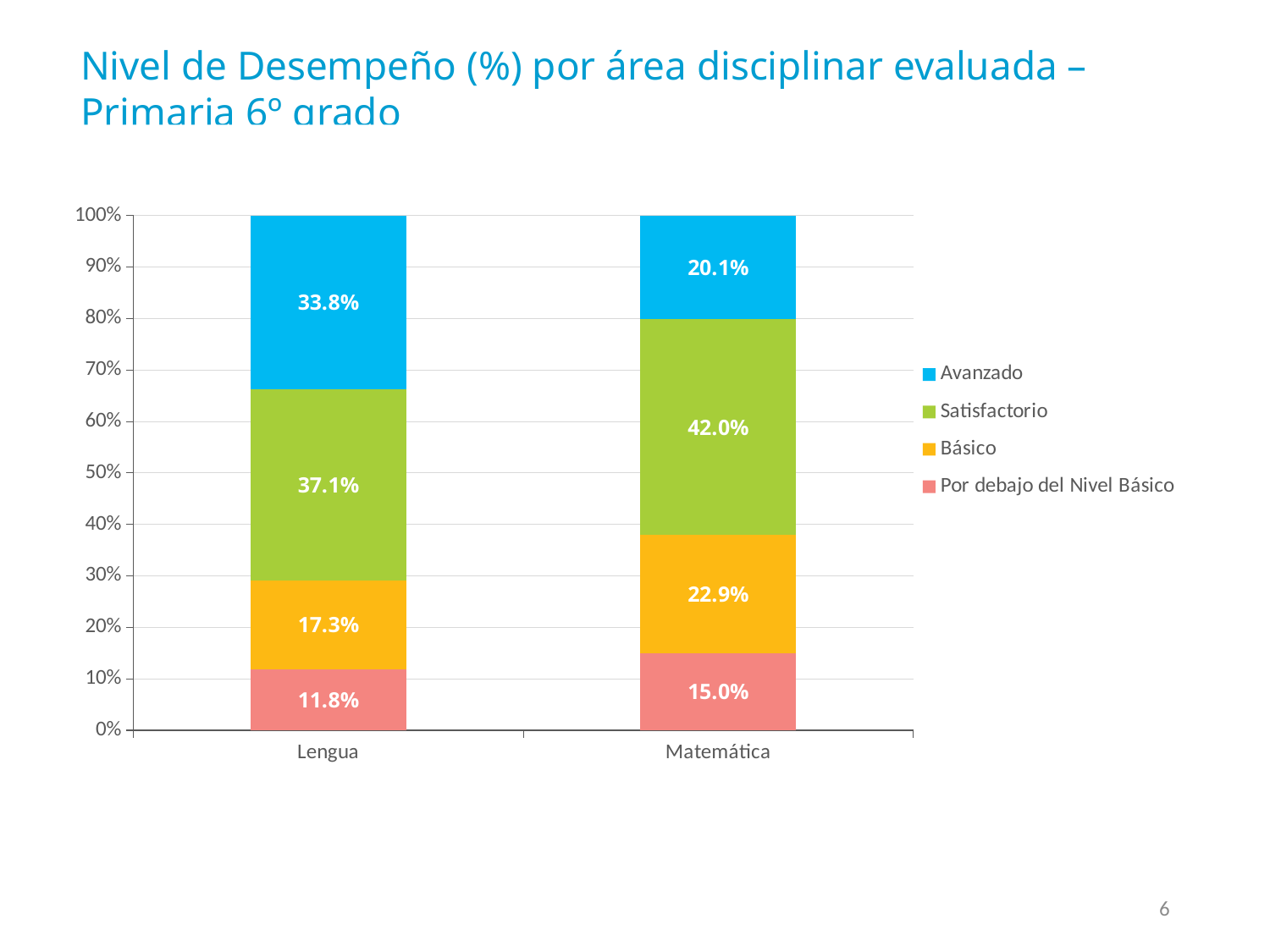
What is the Básico value for Lengua? 17.3% Which level has the lowest value for Lengua? Por debajo del Nivel Básico Which is larger, the Básico value for Lengua or for Matemática? Matemática What is the Avanzado value for Lengua? 33.8% What colour represents the Satisfactorio series? Green What is the difference between the Avanzado values for Lengua and Matemática? 13.7% How many categories are shown on the x axis? 2 What kind of chart is shown on the slide? Stacked bar chart What is the Satisfactorio value for Matemática? 42.0% What is the Por debajo del Nivel Básico value for Matemática? 15.0% How many series does the legend list? 4 Which level has the highest value for Matemática? Satisfactorio